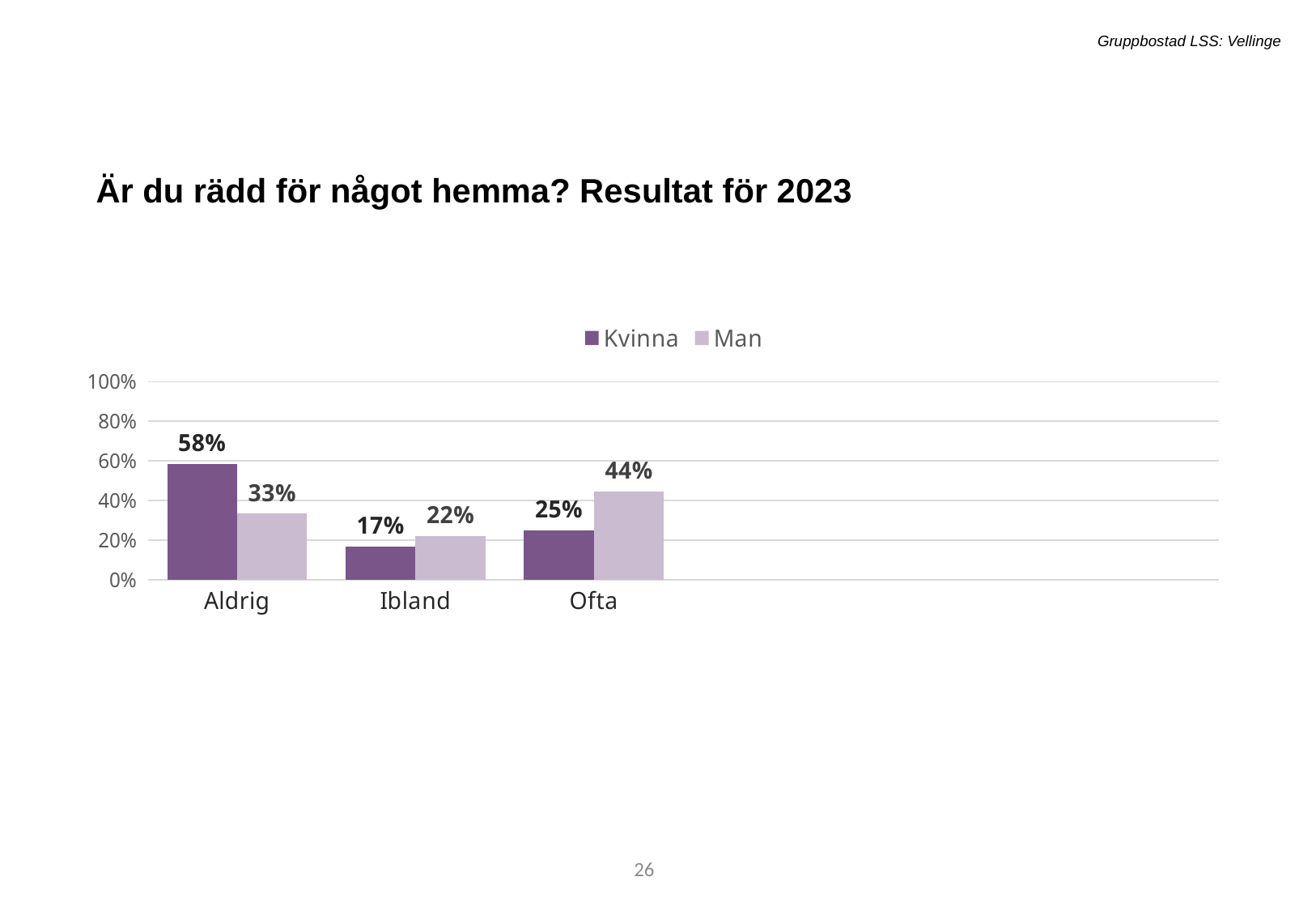
How many series does the legend list? 2 What is the value for Kvinna in the Aldrig category? 58% What is the value for Kvinna in the Ibland category? 17% What are the two series named in the legend? Kvinna and Man In the Ofta category, which series has the larger value, Kvinna or Man? Man Which category has the highest value for the Man series? Ofta What kind of chart is shown on the slide? bar chart How many categories are shown on the x axis? 3 Is the value for Man in the Aldrig category greater or less than 40%? less What is the value for Man in the Ofta category? 44% Which category has the lowest value for the Kvinna series? Ibland What is the difference between the Kvinna and Man values in the Aldrig category? 25%